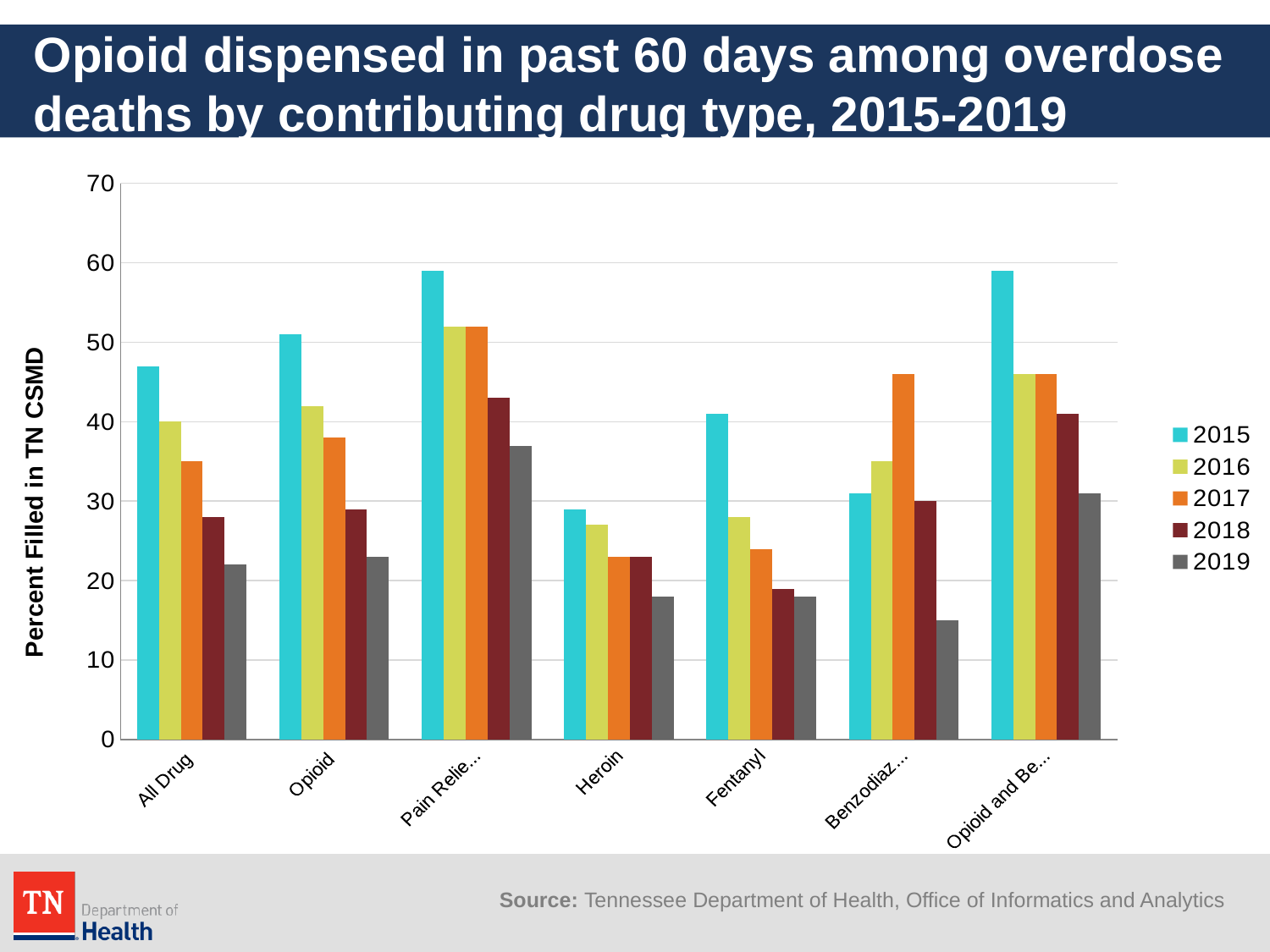
What kind of chart is shown on the slide? Bar chart For the Heroin category, do the values rise or fall from 2015 to 2019? fall What is the title of the y axis? Percent Filled in TN CSMD How many drug-type categories are shown along the x axis? 7 For the All Drug category, which year has the lowest bar? 2019 Is the 2019 value for Fentanyl greater or less than 20? less Is the 2015 value for All Drug greater or less than 40? greater Is the 2019 value for Heroin greater or less than 20? less Which is larger, the 2015 value for Heroin or the 2015 value for Fentanyl? Fentanyl How many series does the legend list? 5 For the All Drug category, which year has the highest bar? 2015